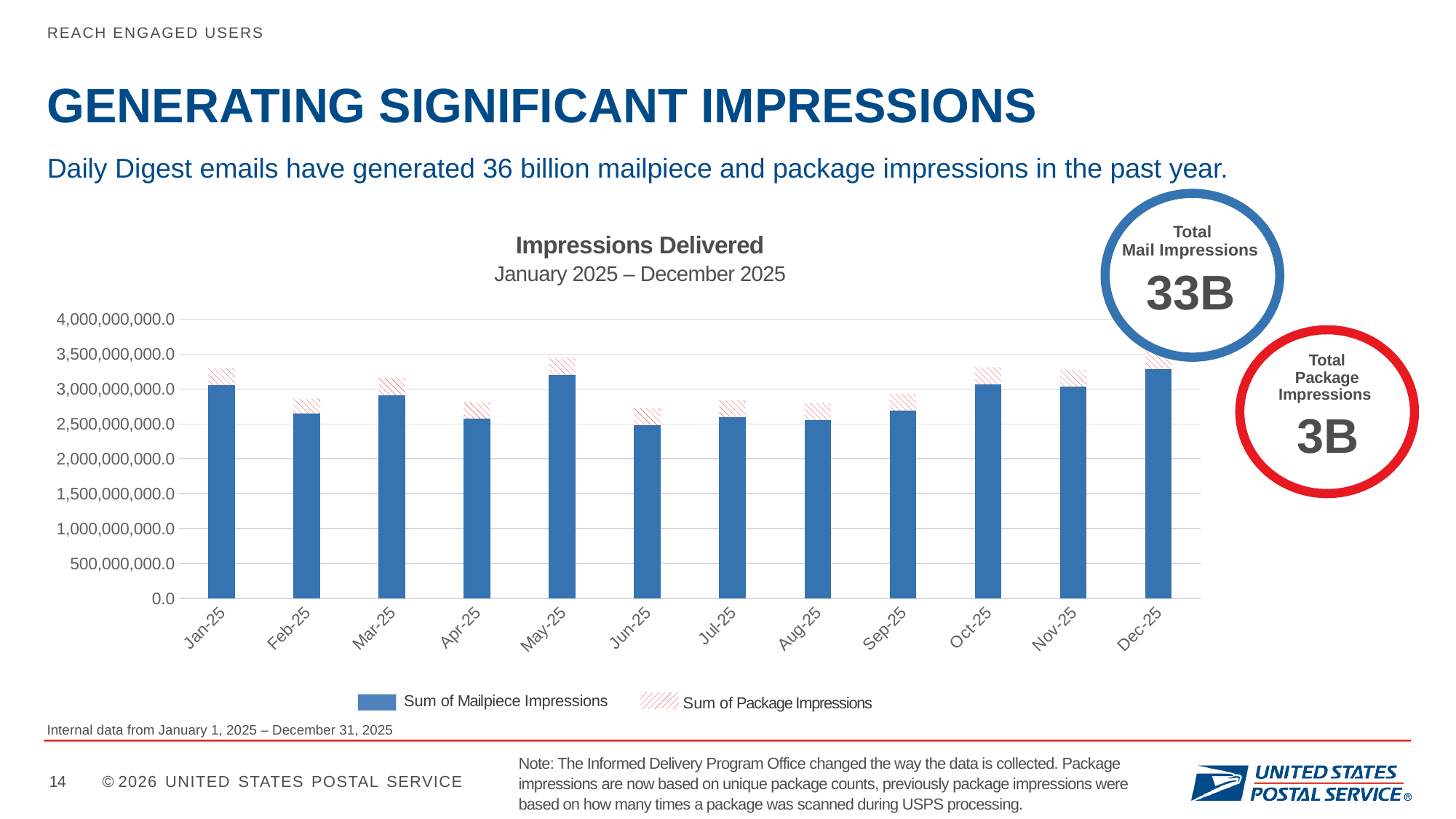
Is the Sum of Mailpiece Impressions for May-25 greater or less than 3,000,000,000.0? greater Which month has a larger Sum of Mailpiece Impressions, Jan-25 or Feb-25? Jan-25 Which series is shown with the solid blue bars? Sum of Mailpiece Impressions Is the Sum of Mailpiece Impressions for Dec-25 greater or less than 3,000,000,000.0? greater How many series does the chart legend list? 2 Is the Sum of Mailpiece Impressions for Feb-25 greater or less than 3,000,000,000.0? less What is the title of the chart? Impressions Delivered What total mail impressions figure is shown in the blue circle next to the chart? 33B Which month has a larger Sum of Mailpiece Impressions, May-25 or Jun-25? May-25 What type of chart is shown on the slide? Stacked bar chart How many months are shown on the x axis of the chart? 12